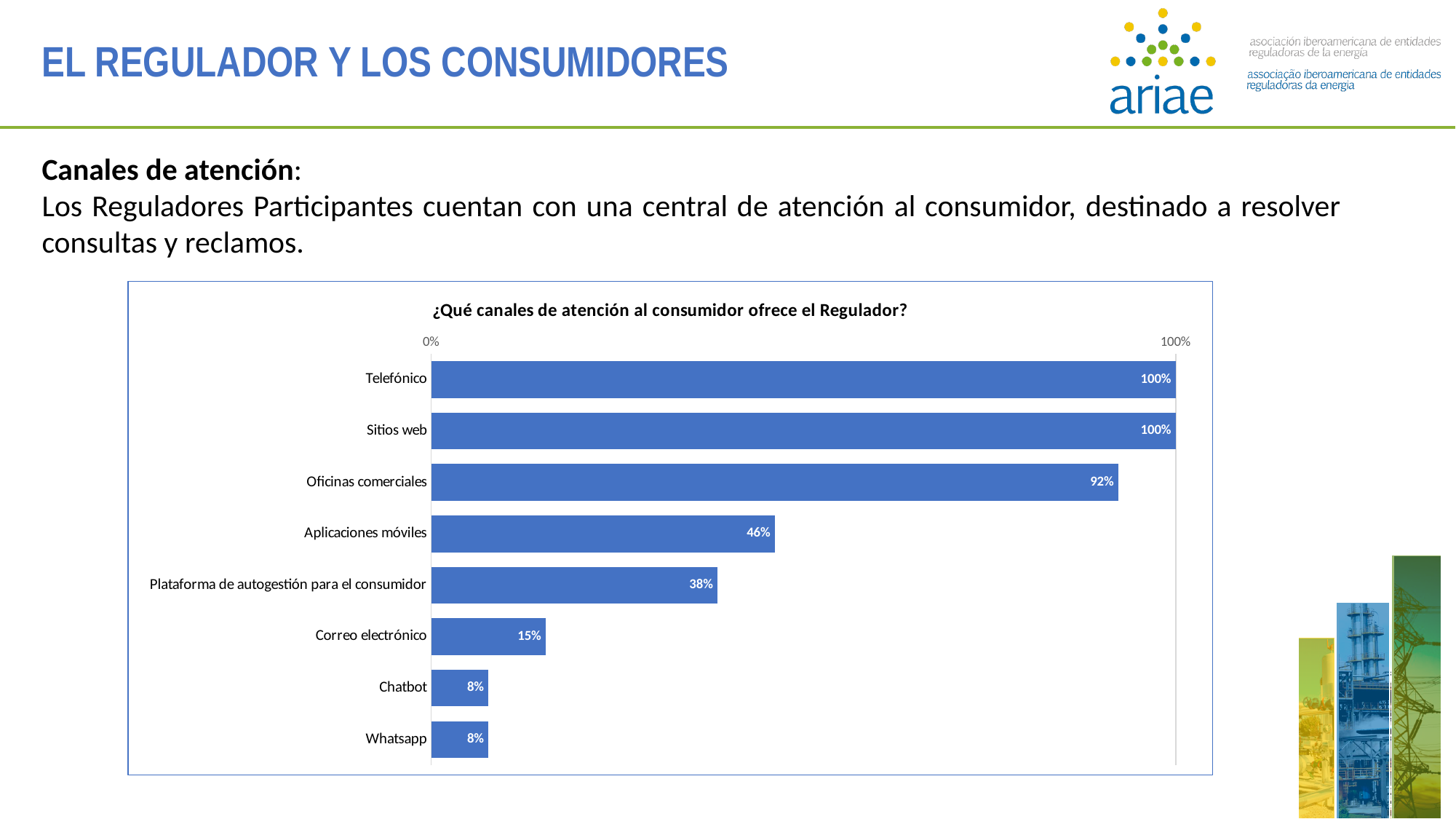
What is the difference between the values for Oficinas comerciales and Aplicaciones móviles? 46% Which is larger, the value for Correo electrónico or the value for Whatsapp? Correo electrónico What is the value for Correo electrónico? 15% What is the difference between the values for Aplicaciones móviles and Plataforma de autogestión para el consumidor? 8% What is the value for Plataforma de autogestión para el consumidor? 38% What is the title of the chart? ¿Qué canales de atención al consumidor ofrece el Regulador? Which categories have the highest value? Telefónico and Sitios web What is the value for Chatbot? 8% What kind of chart is shown on the slide? Bar chart What is the value for Aplicaciones móviles? 46% How many categories are shown in the chart? 8 What is the value for Oficinas comerciales? 92%